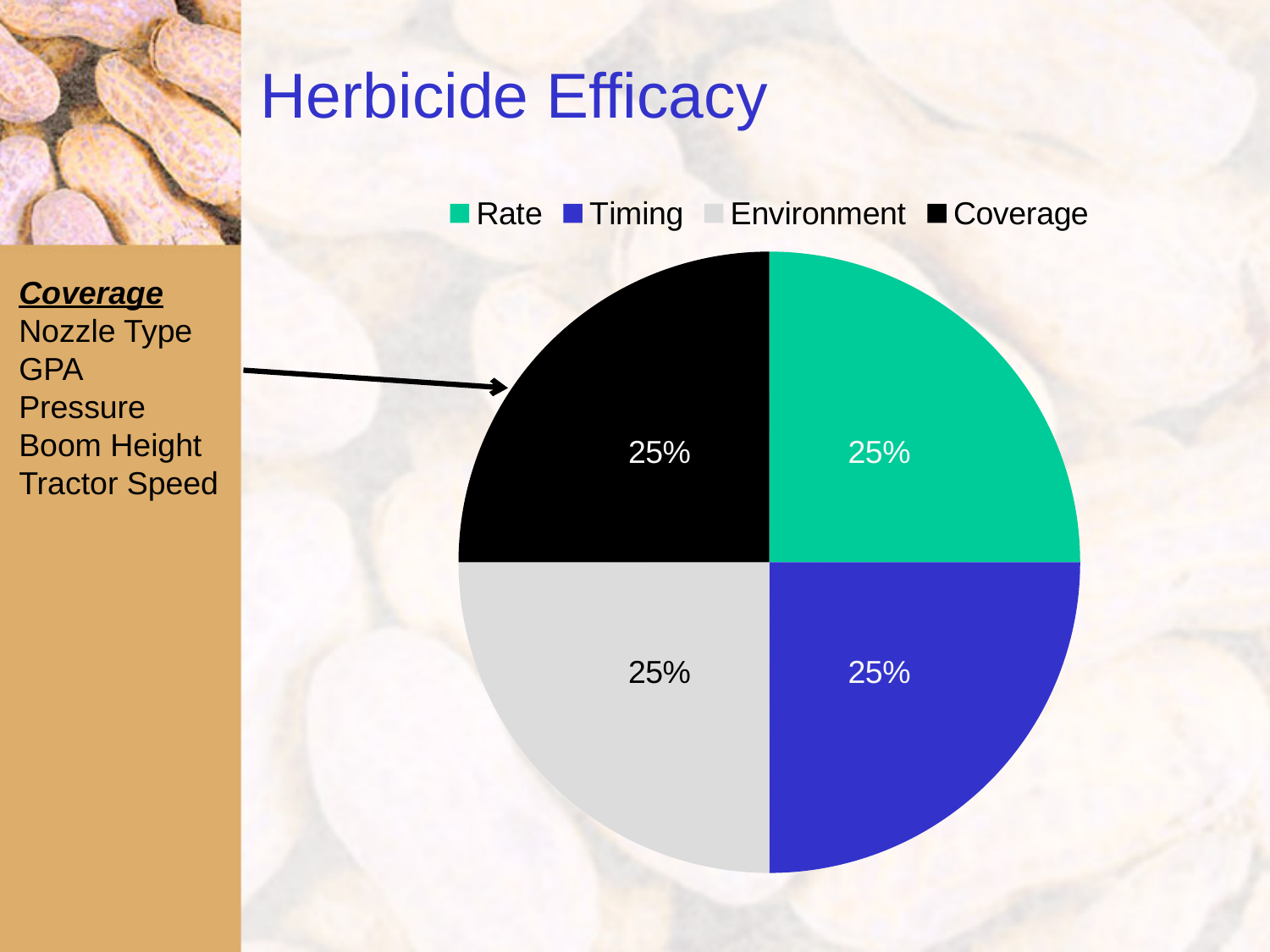
How many entries does the legend list? 4 What kind of chart is shown on the slide? pie chart What share of the pie does the Rate slice represent? 25% What is the combined share of the Rate and Coverage slices? 50% What share of the pie does the Coverage slice represent? 25% How many slices does the pie chart have? 4 What share of the pie does the Environment slice represent? 25% Which legend entry is shown in light grey? Environment What is the difference between the Rate share and the Timing share? 0% Which legend entry is shown in black? Coverage